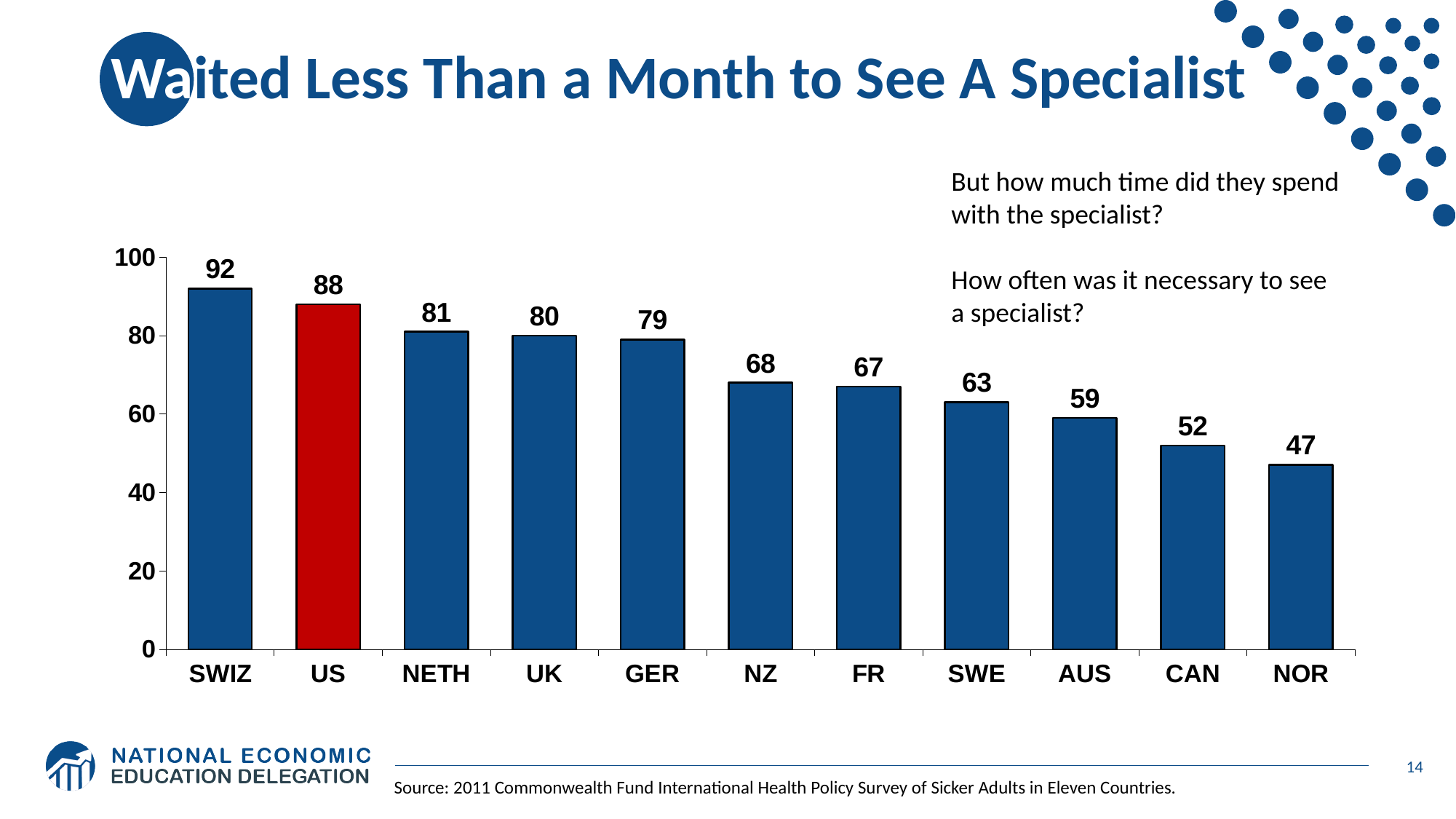
What is the difference between the values for SWIZ and the US? 4 What is the value for NOR? 47 Which is larger, the value for SWE or the value for AUS? SWE Which country has the lowest value? NOR What is the value for GER? 79 What is the difference between the values for NZ and CAN? 16 Is the value for FR greater or less than 60? greater How many countries are shown on the chart? 11 What kind of chart is shown on the slide? bar chart Which country has the highest value? SWIZ What is the value for the US? 88 Which country's bar is coloured red? US